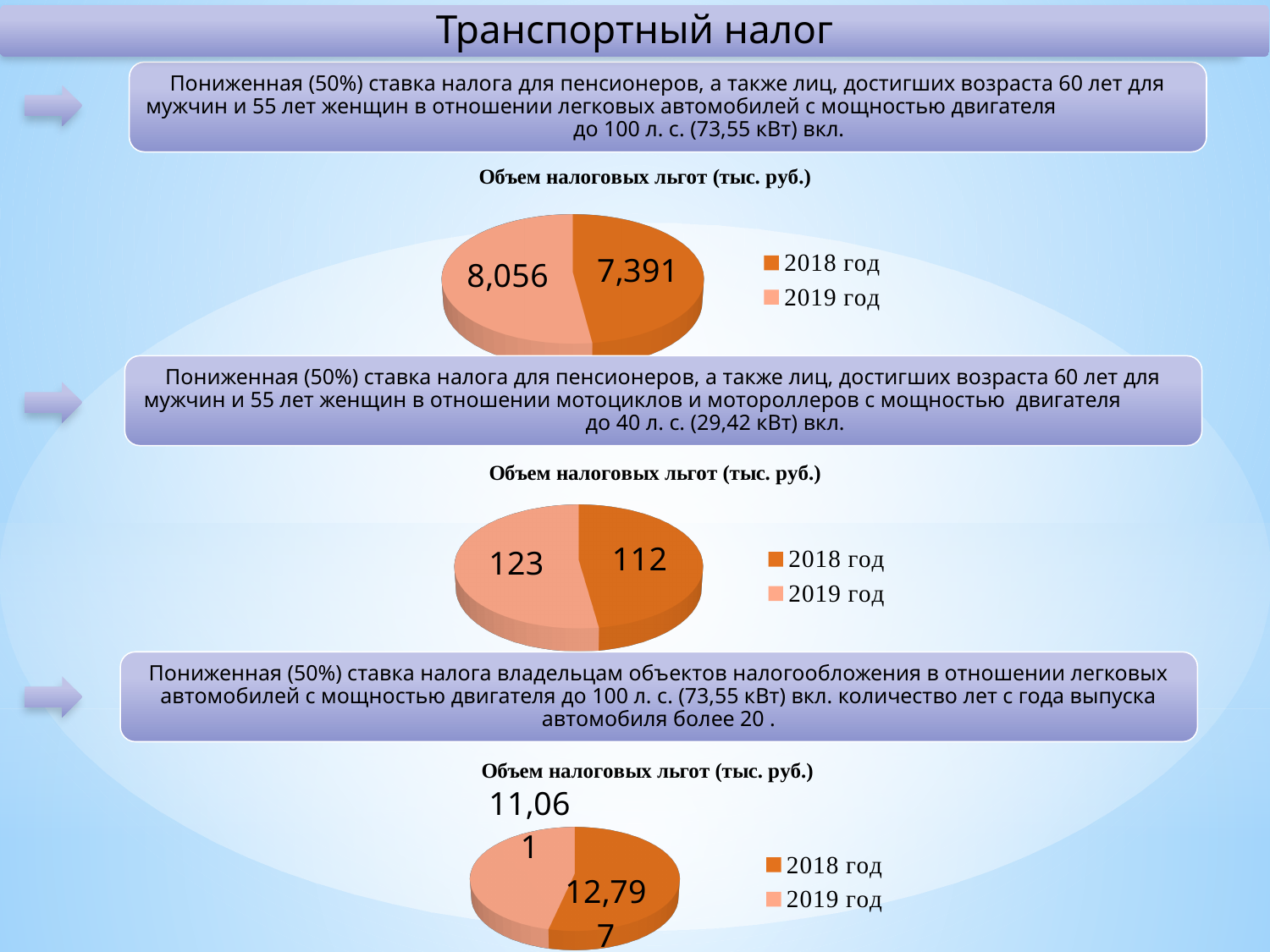
In the top pie chart, which year has the larger value? 2019 год What is the title of the bottom pie chart? Объем налоговых льгот (тыс. руб.) In the bottom pie chart, which year has the larger value, 2018 год or 2019 год? 2018 год In the middle pie chart, which year has the smaller value? 2018 год In the middle pie chart, what is the value for 2018 год? 112 What type of chart is used for the middle chart on the slide? Pie chart In the middle pie chart, what is the difference between the 2019 год and 2018 год values? 11 In the middle pie chart, what is the value for 2019 год? 123 In the top pie chart, what is the value for 2019 год? 8,056 In the top pie chart, what is the difference between the 2019 год and 2018 год values? 665 How many series does the legend of the top pie chart list? 2 In the top pie chart, what is the value for 2018 год? 7,391